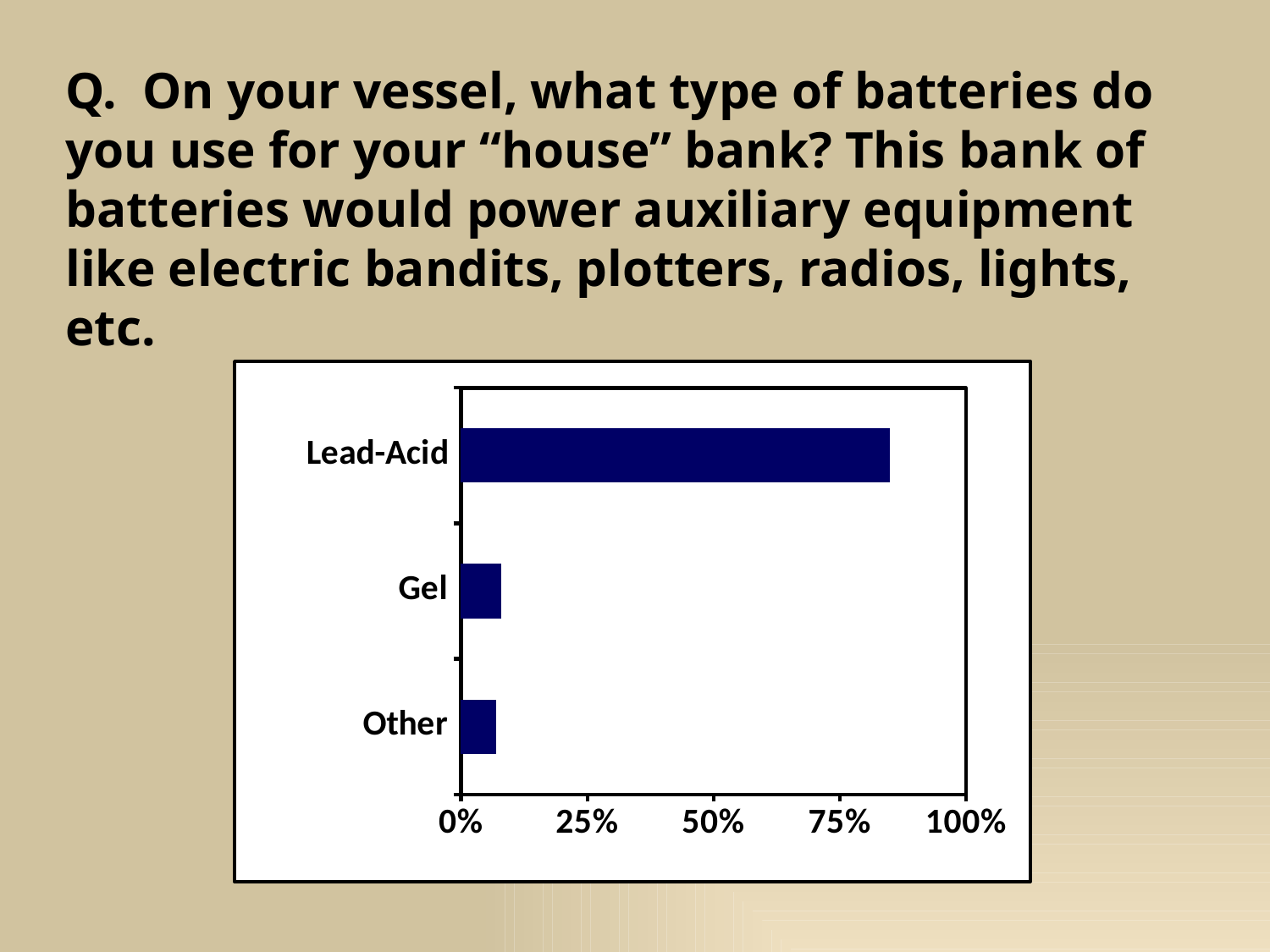
Which is larger, the value for Other or the value for Lead-Acid? Lead-Acid Is the value for Other greater or less than 25%? less Which battery type has the highest value in the chart? Lead-Acid Is the value for Lead-Acid greater or less than 75%? greater What kind of chart is shown on the slide? bar chart What is the highest value shown on the horizontal axis of the chart? 100% Which is larger, the value for Lead-Acid or the value for Gel? Lead-Acid How many battery types (categories) are shown in the chart? 3 What colour are the bars in the chart? dark blue Is the value for Gel greater or less than 25%? less